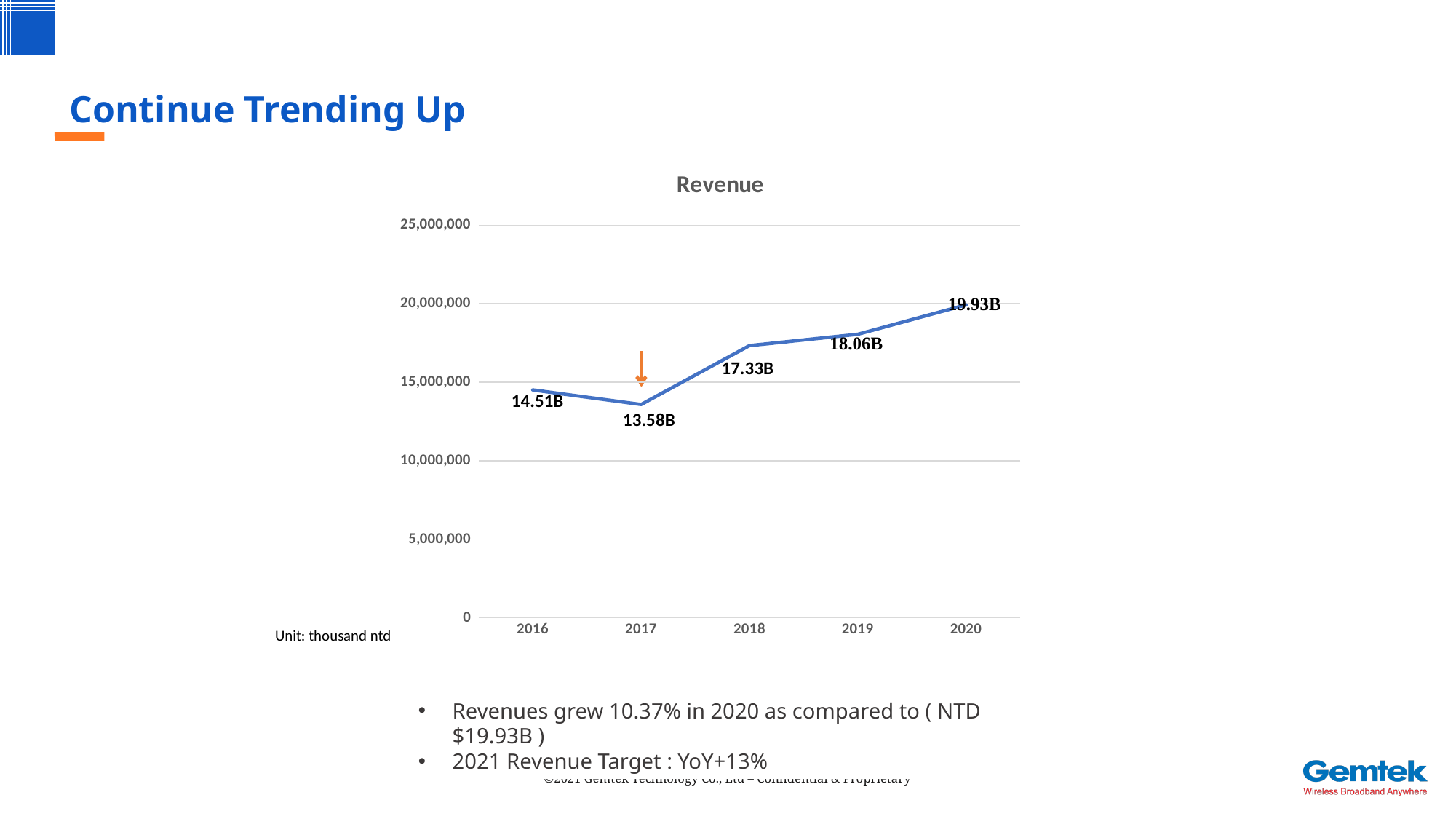
Which year has the highest revenue? 2020 Is the revenue for 2018 greater or less than 15,000,000? greater What is the difference between the revenue in 2020 and the revenue in 2019? 1.87B What is the title of the chart? Revenue Does revenue rise or fall from 2017 to 2020? rise Which year has the larger revenue, 2018 or 2019? 2019 Which year has the lowest revenue? 2017 How many years are plotted on the x axis? 5 What is the revenue value shown for 2020? 19.93B What is the revenue value shown for 2017? 13.58B What is the revenue value shown for 2016? 14.51B What kind of chart is shown on the slide? line chart